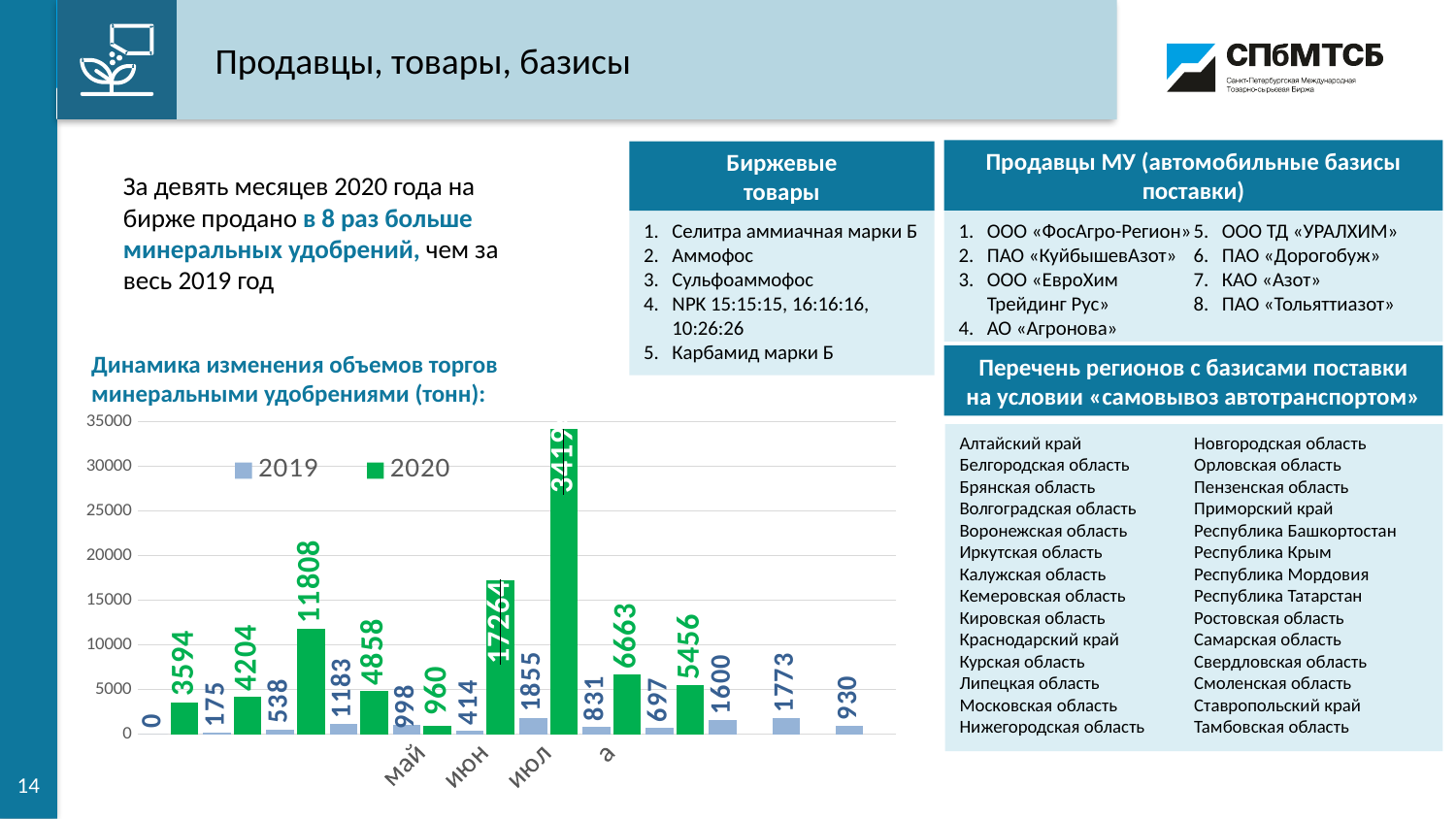
What is the value for 2019 in июн? 414 What is the highest value shown for the 2019 series? 1855 In май, which series has the larger value, 2019 or 2020? 2019 What is the difference between the 2020 and 2019 values in июн? 16850 What type of chart is shown on the slide? bar chart What is the difference between the 2020 and 2019 values in июл? 32339 Which month has the highest value in the 2020 series? июл What is the value for 2020 in май? 960 How many series does the chart legend list? 2 Do the 2020 values rise or fall from май to июл? rise What is the value for 2020 in июл? 34194 Is the 2020 value for июн greater or less than 15000? greater